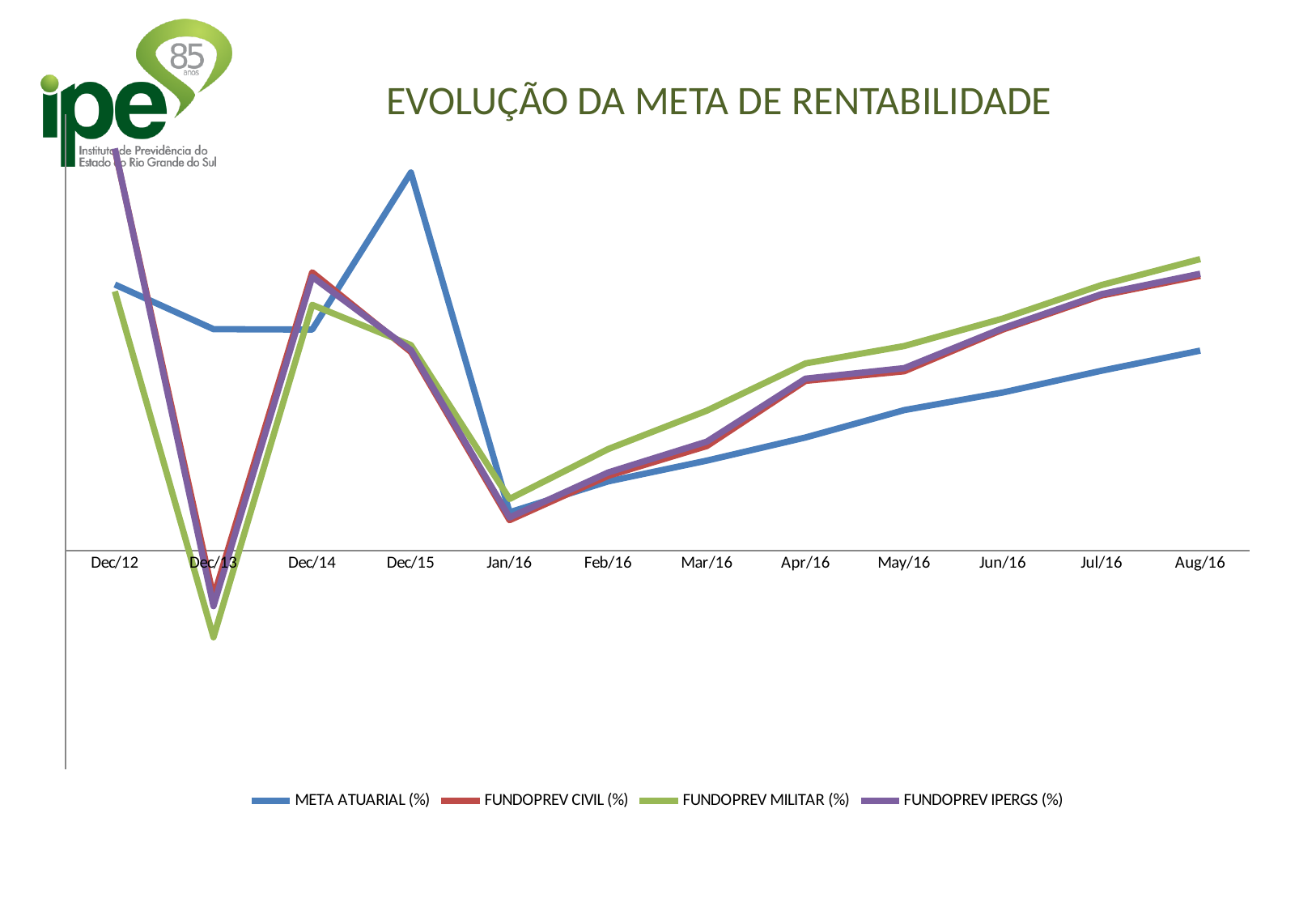
How many series does the legend list? 4 How many dates are plotted along the x axis? 12 Which series is drawn in green in the legend? FUNDOPREV MILITAR (%) What is the title of the chart? EVOLUÇÃO DA META DE RENTABILIDADE At which date does FUNDOPREV MILITAR (%) reach its lowest value? Dec/13 Is META ATUARIAL (%) higher at Dec/14 or at Dec/15? Dec/15 At which date does META ATUARIAL (%) reach its lowest value? Jan/16 Which series has the lowest value at Aug/16? META ATUARIAL (%) What kind of chart is shown on the slide? Line chart At which date does META ATUARIAL (%) reach its highest value? Dec/15 Which series has the highest value at Aug/16? FUNDOPREV MILITAR (%) Do the series rise or fall from Jan/16 to Aug/16? Rise